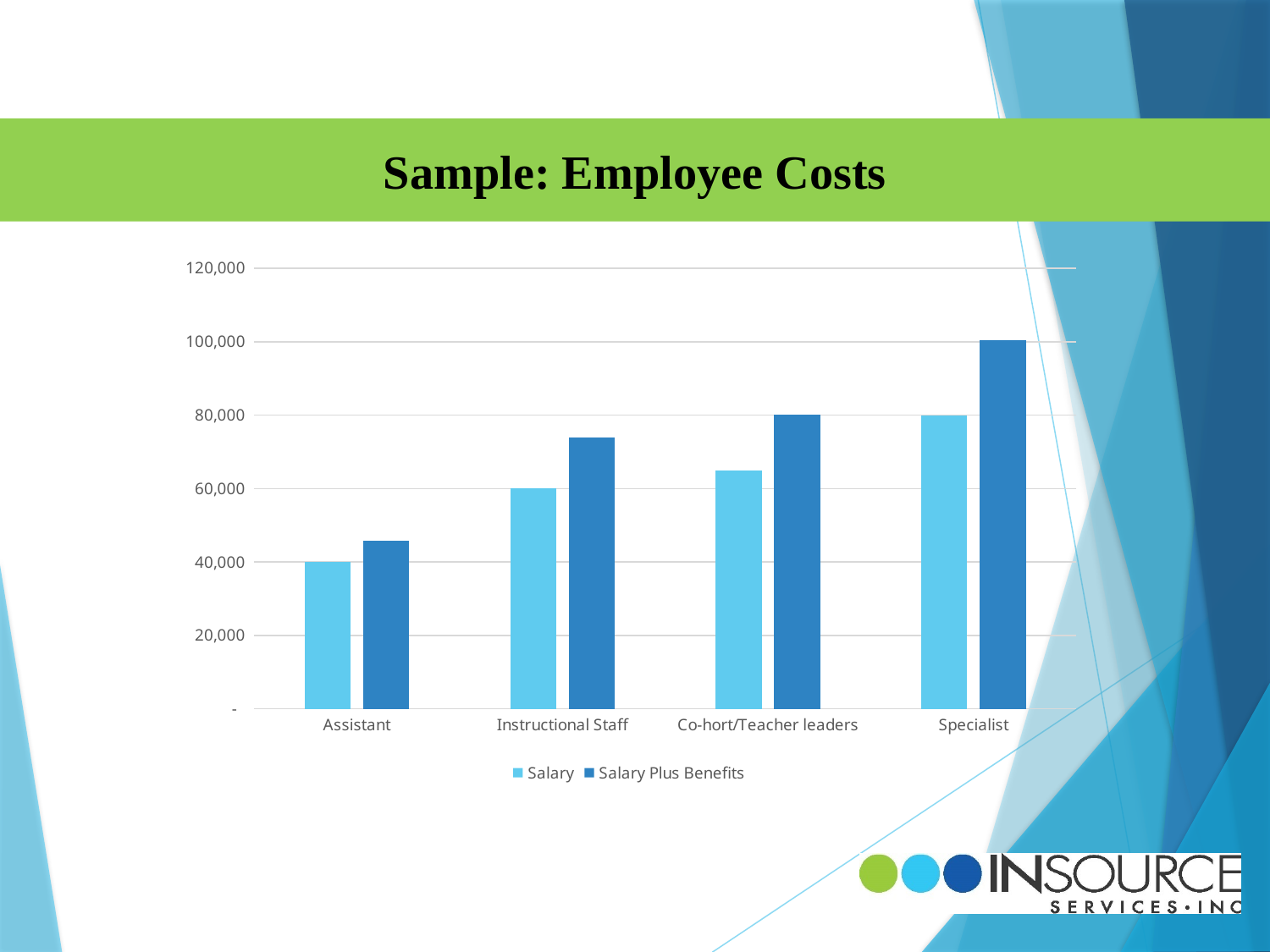
What kind of chart is shown on the slide? Bar chart How many categories are shown on the x axis? 4 Is the Salary value for Co-hort/Teacher leaders greater or less than 60,000? greater What is the Salary value for Instructional Staff? 60,000 Is the Salary Plus Benefits value for Assistant greater or less than 40,000? greater How many series does the legend list? 2 Which category has the highest Salary Plus Benefits value? Specialist What is the Salary value for Assistant? 40,000 Which category has the lowest Salary value? Assistant